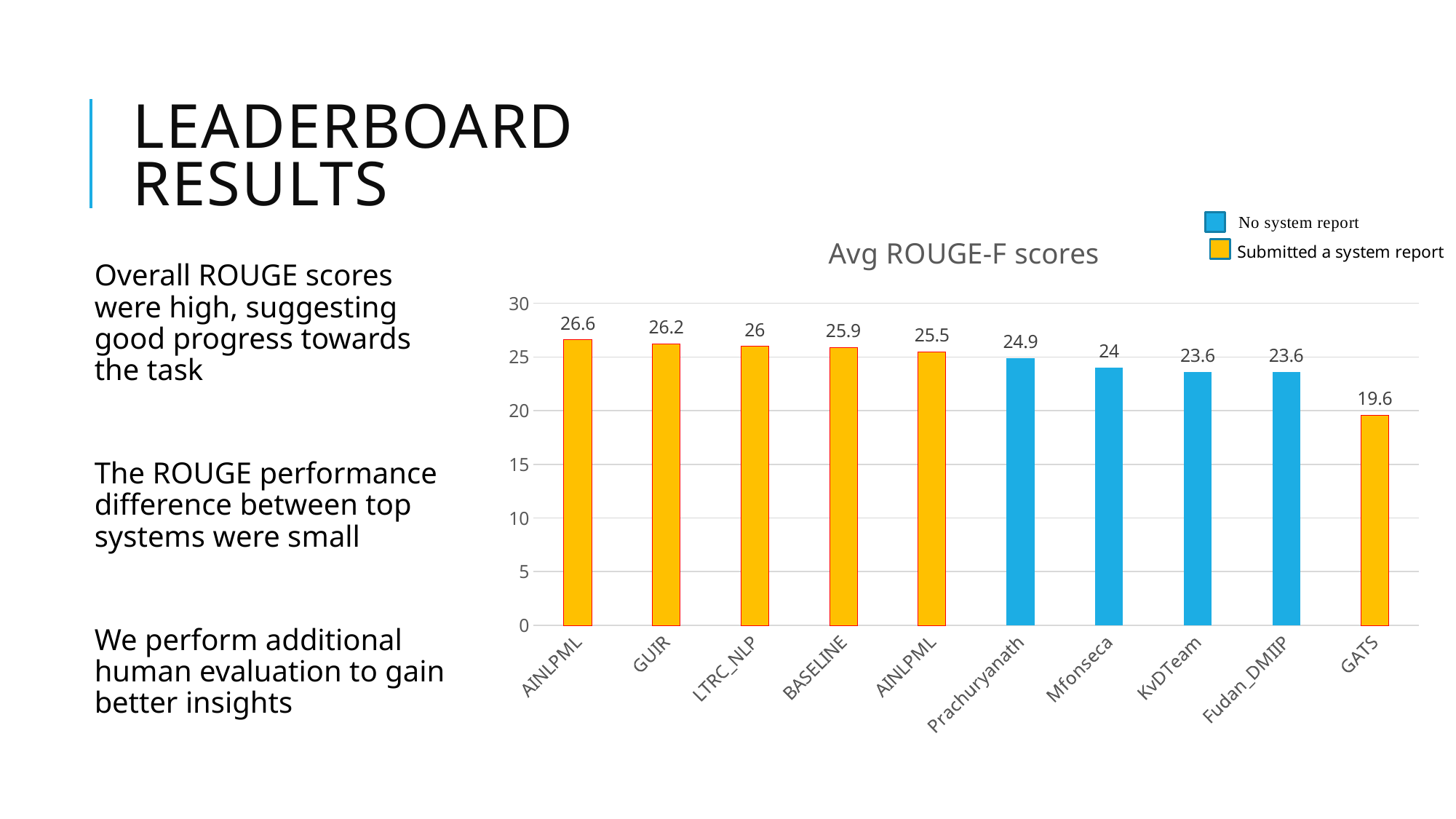
Which system has the highest Avg ROUGE-F score? AINLPML What is the Avg ROUGE-F score for GATS? 19.6 How many systems are shown in the Avg ROUGE-F scores chart? 10 What is the difference between the Avg ROUGE-F scores of GUIR and GATS? 6.6 What is the Avg ROUGE-F score for Prachuryanath? 24.9 What kind of chart is used to show the Avg ROUGE-F scores? Bar chart Which has a higher Avg ROUGE-F score, Mfonseca or LTRC_NLP? LTRC_NLP What is the Avg ROUGE-F score for BASELINE? 25.9 Do the Avg ROUGE-F scores rise or fall from left to right across the chart? Fall According to the legend, what does a blue bar indicate? No system report What is the Avg ROUGE-F score for GUIR? 26.2 Which system has the lowest Avg ROUGE-F score? GATS